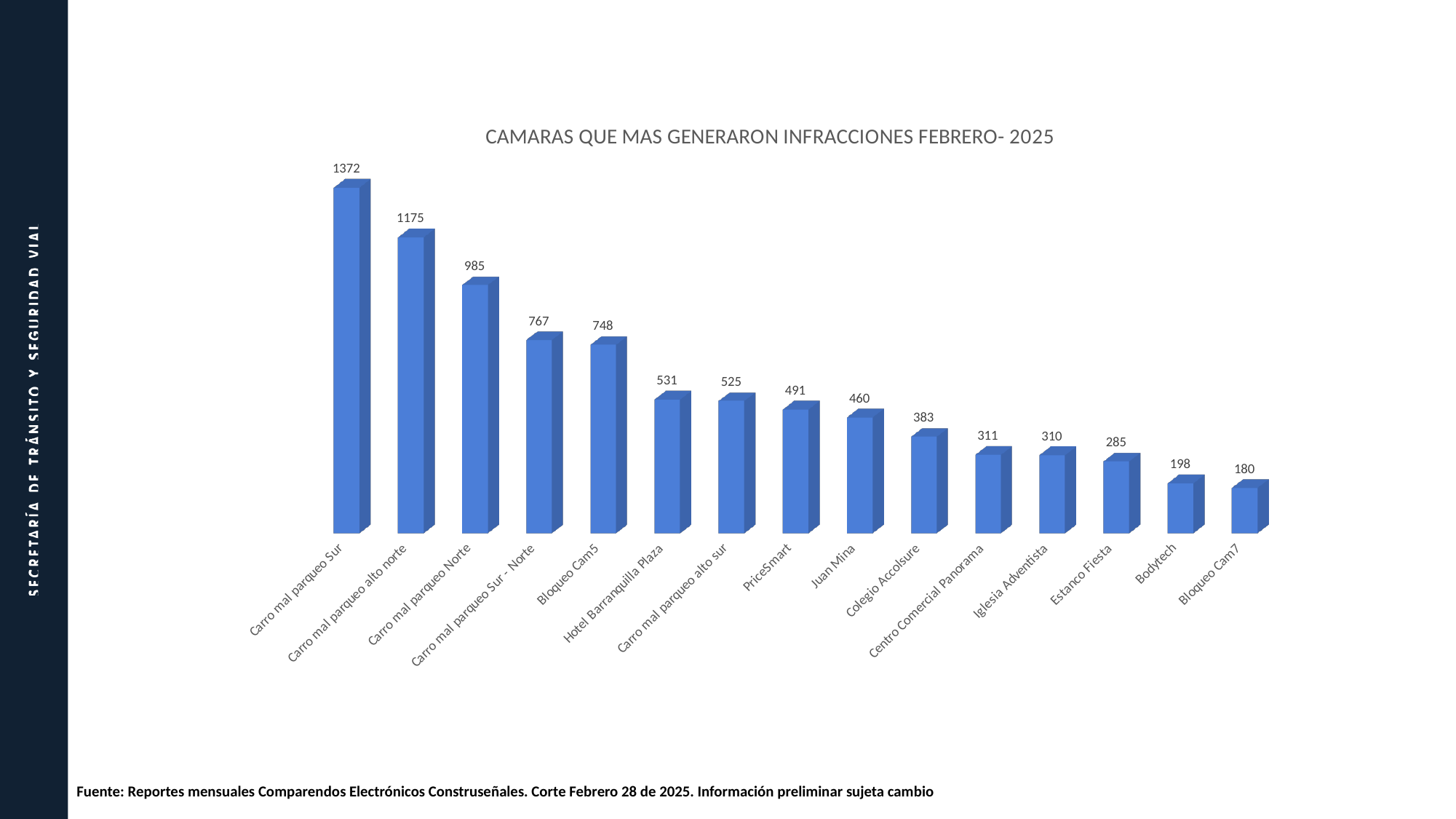
What kind of chart is shown on the slide? Bar chart What is the value for Iglesia Adventista? 310 What is the title of the chart? CAMARAS QUE MAS GENERARON INFRACCIONES FEBRERO- 2025 What is the value for Carro mal parqueo Sur? 1372 Which is larger, Carro mal parqueo Sur - Norte or Bloqueo Cam5? Carro mal parqueo Sur - Norte What is the value for Hotel Barranquilla Plaza? 531 What is the difference between Bodytech and Bloqueo Cam7? 18 Which camera has the highest number of infractions? Carro mal parqueo Sur What is the difference between Carro mal parqueo Sur and Carro mal parqueo alto norte? 197 How many cameras are shown in the chart? 15 Which is larger, PriceSmart or Juan Mina? PriceSmart Which camera has the lowest number of infractions? Bloqueo Cam7